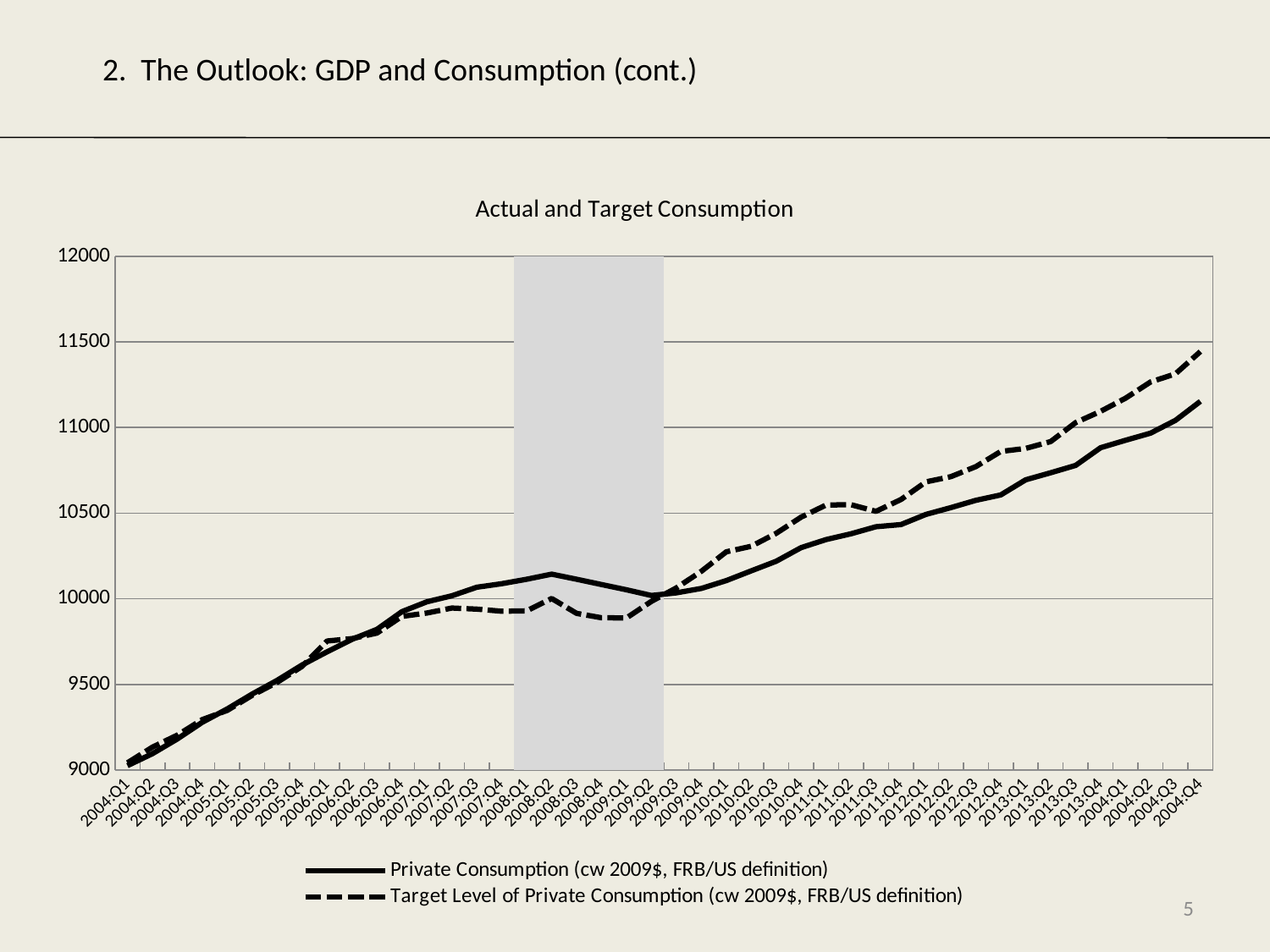
Is the value of Private Consumption at 2010:Q4 greater or less than 10500? less Overall, does the Private Consumption series rise or fall from the first quarter to the last quarter on the x axis? rise What is the title of the chart? Actual and Target Consumption Which series is drawn with a dashed line? Target Level of Private Consumption (cw 2009$, FRB/US definition) How many series does the legend list? 2 At 2008:Q2, which series has the higher value: Private Consumption or Target Level of Private Consumption? Private Consumption Is the value of Target Level of Private Consumption at 2013:Q4 greater or less than 11000? greater Is the value of Target Level of Private Consumption at 2008:Q4 greater or less than 10000? less At the last quarter on the x axis, which series has the higher value: Private Consumption or Target Level of Private Consumption? Target Level of Private Consumption What type of chart is shown on the slide? line chart